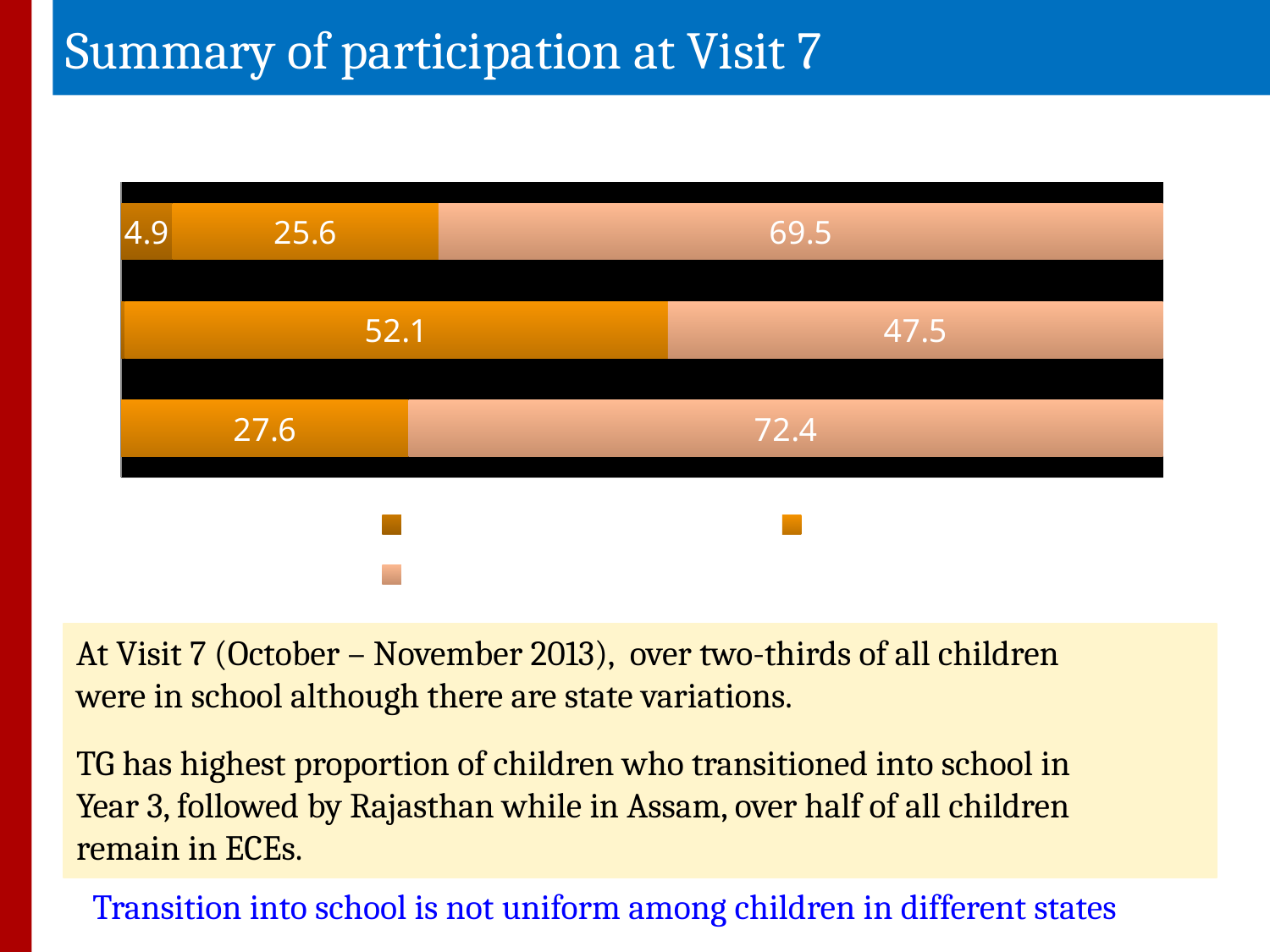
How many colour swatches does the legend show? 3 Which bar has the smallest orange segment? the top bar What is the value of the dark brown segment in the top bar? 4.9 What kind of chart is shown on the slide? stacked bar chart What is the value of the orange segment in the bottom bar? 27.6 What is the value of the orange segment in the middle bar? 52.1 What is the difference between the light salmon segment and the orange segment in the bottom bar? 44.8 What is the value of the light salmon segment in the top bar? 69.5 How many bars does the chart contain? 3 What is the total of the segments in the top bar? 100.0 In the middle bar, which is larger, the orange segment or the light salmon segment? the orange segment Which bar has the largest light salmon segment? the bottom bar